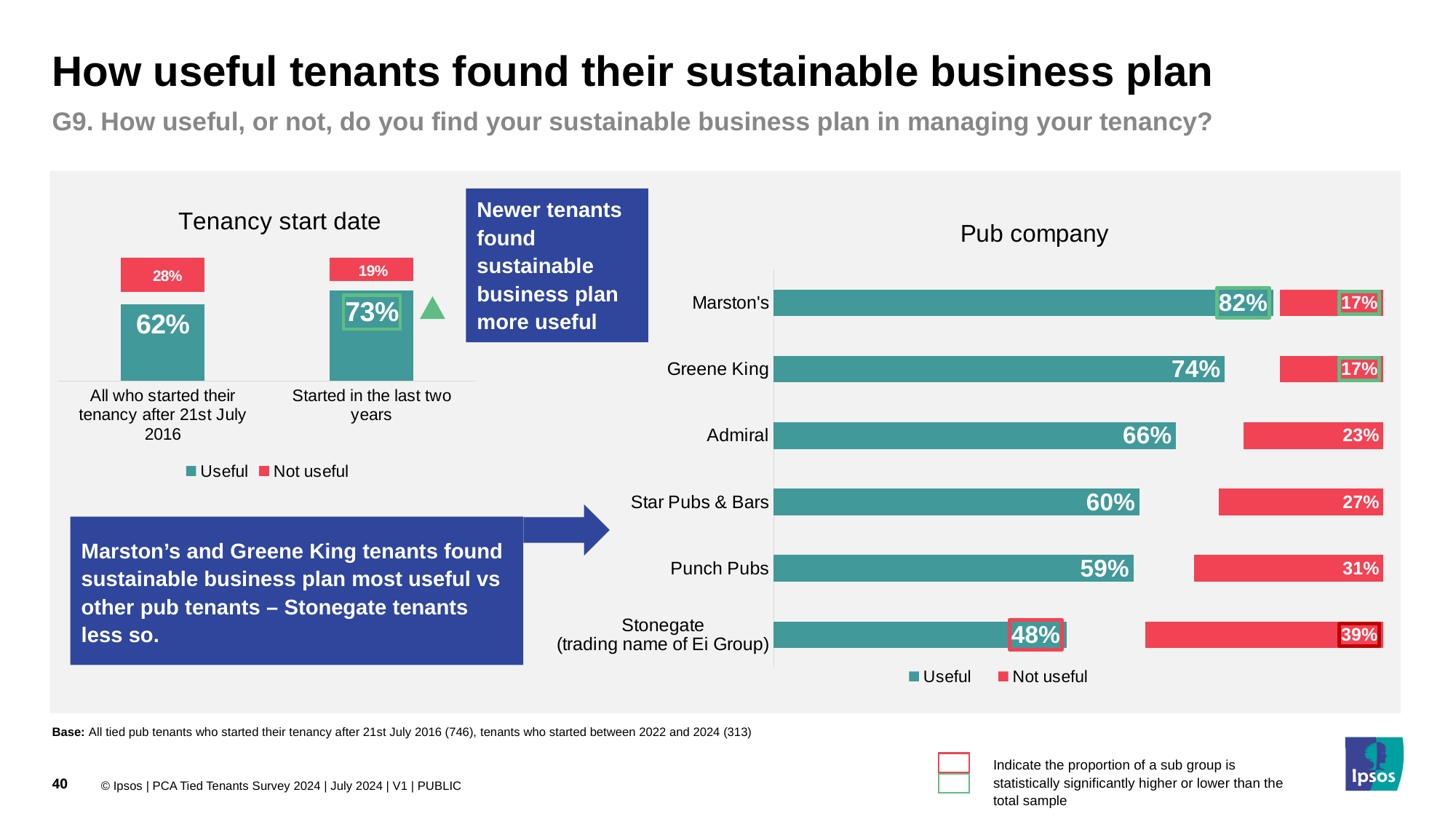
In the 'Pub company' chart, which pub company has the lowest 'Useful' value? Stonegate (trading name of Ei Group) In the 'Pub company' chart, which is larger: the 'Not useful' value for Star Pubs & Bars or for Admiral? Star Pubs & Bars How many pub companies are shown in the 'Pub company' chart? 6 In the 'Pub company' chart, which pub company has the highest 'Not useful' value? Stonegate (trading name of Ei Group) In the 'Pub company' chart, what is the 'Not useful' value for Punch Pubs? 31% How many series does the legend of the 'Pub company' chart list? 2 In the 'Tenancy start date' chart, what is the difference between the 'Useful' values for the two groups? 11 percentage points In the 'Tenancy start date' chart, what percentage of all who started their tenancy after 21st July 2016 found the plan useful? 62% In the 'Pub company' chart, which pub company has the highest 'Useful' value? Marston's In the 'Pub company' chart, what is the difference between the 'Useful' values for Marston's and Greene King? 8 percentage points In the 'Tenancy start date' chart, what is the 'Not useful' value for those who started in the last two years? 19% In the 'Pub company' chart, what is the 'Useful' value for Admiral? 66%